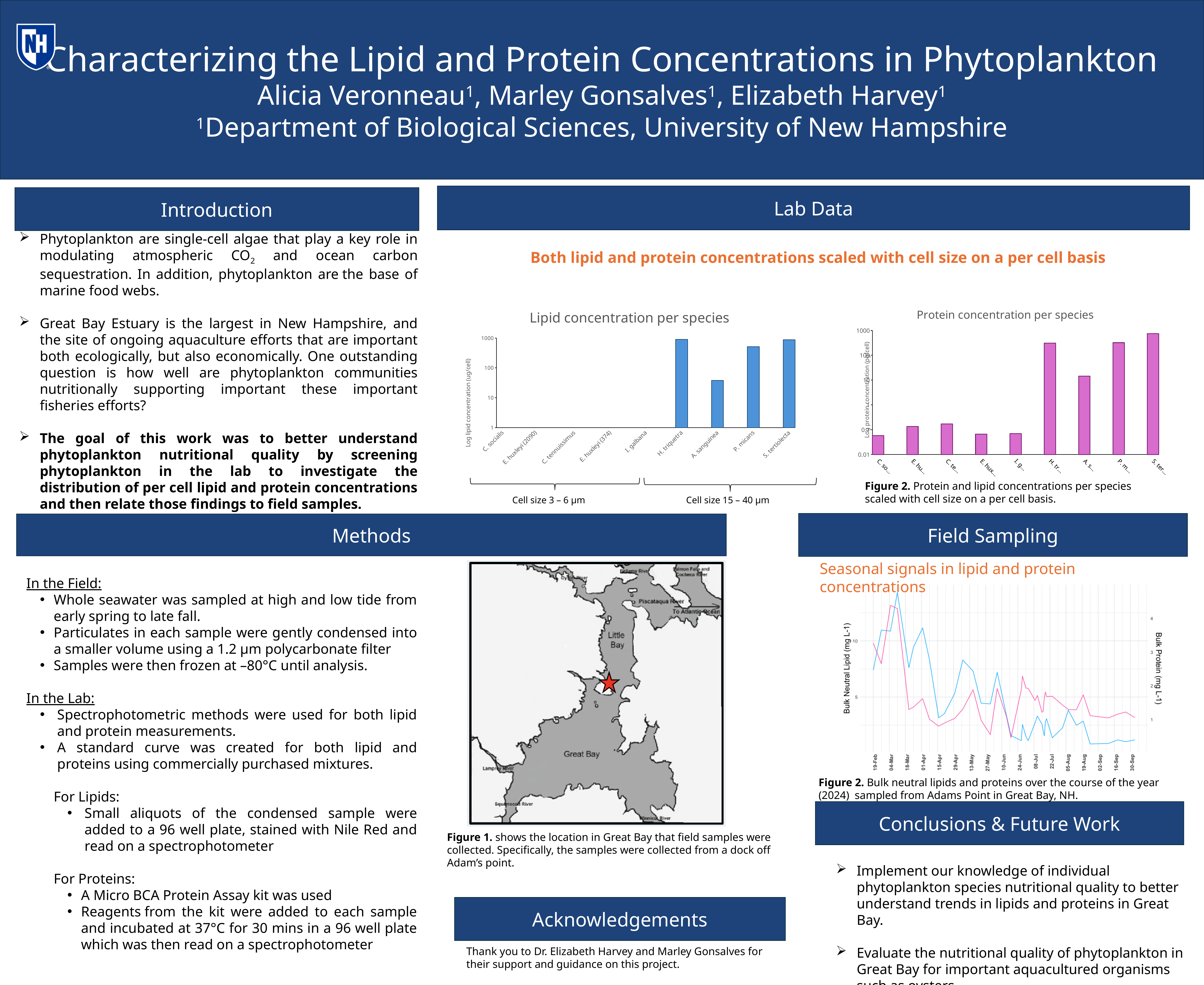
What kind of chart is the 'Lipid concentration per species' chart? bar chart In the 'Lipid concentration per species' chart, is the value for P. micans greater or less than 100? greater How many species are listed on the x axis of the 'Lipid concentration per species' chart? 9 In the 'Protein concentration per species' chart, is the value for A. sanguinea greater or less than 100? less In the 'Protein concentration per species' chart, which species has the highest protein concentration? S. tertiolecta What is the y-axis label of the 'Lipid concentration per species' chart? Log lipid concentration (ug/cell) In the 'Lipid concentration per species' chart, which is larger, the value for H. triquetra or the value for A. sanguinea? H. triquetra What kind of chart is the 'Seasonal signals in lipid and protein concentrations' chart in the Field Sampling section? line chart In the 'Lipid concentration per species' chart, is the value for H. triquetra greater or less than 100? greater In the Field Sampling line chart, does the Bulk Neutral Lipid line generally rise or fall from February to September? fall In the 'Protein concentration per species' chart, which is larger, the value for H. triquetra or the value for A. sanguinea? H. triquetra